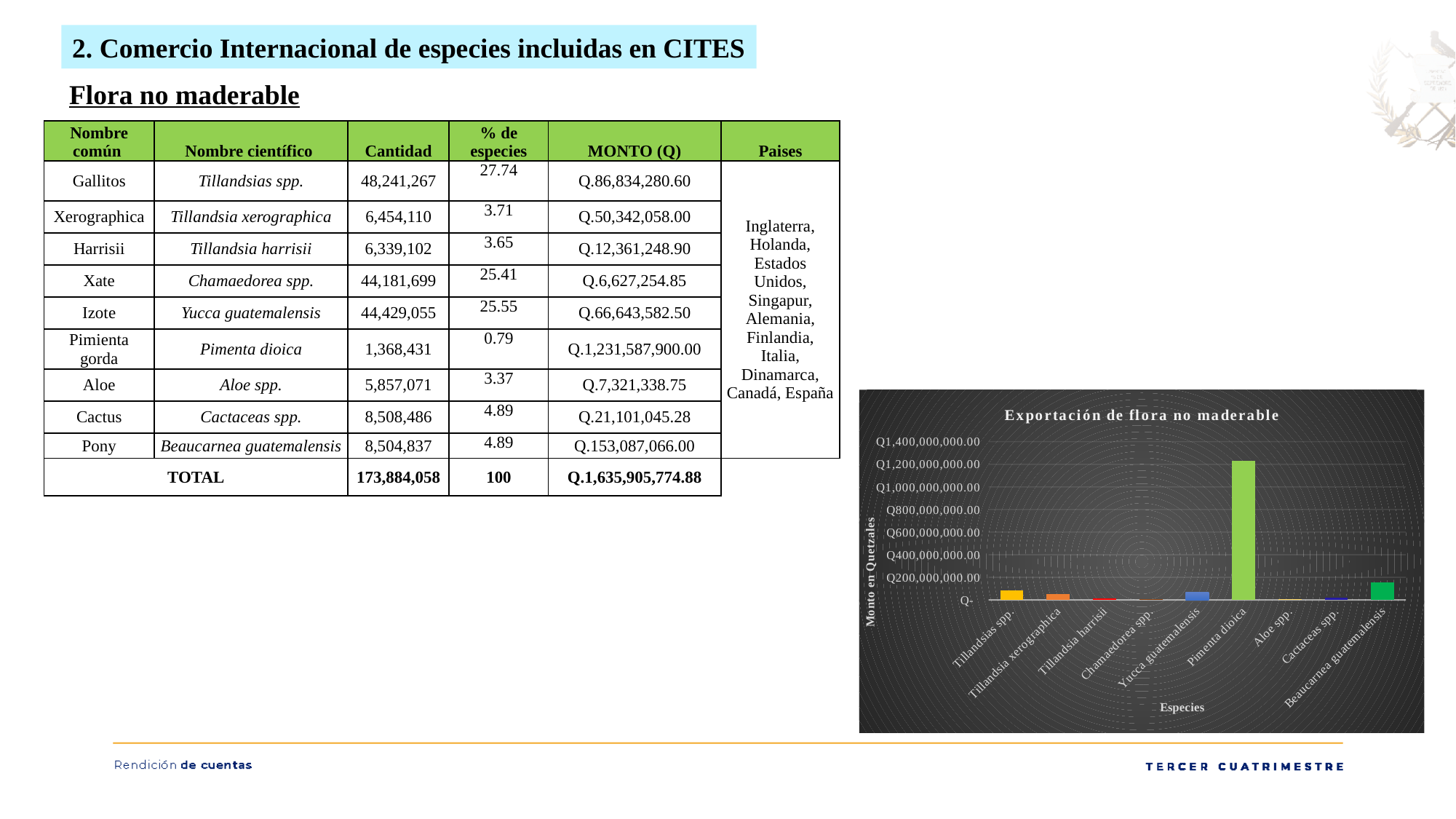
What kind of chart is shown on the slide? bar chart What is the title of the chart? Exportación de flora no maderable In the chart, which bar is taller: Tillandsias spp. or Tillandsia harrisii? Tillandsias spp. Is the value for Tillandsias spp. in the chart greater or less than Q200,000,000.00? less What is the label of the vertical axis of the chart? Monto en Quetzales Which species has the highest bar in the chart? Pimenta dioica According to the table on the slide, what is the MONTO (Q) for Pimenta dioica, the tallest bar in the chart? Q.1,231,587,900.00 Is the value for Beaucarnea guatemalensis in the chart greater or less than Q200,000,000.00? less In the chart, which bar is taller: Pimenta dioica or Yucca guatemalensis? Pimenta dioica How many species categories are plotted on the x axis of the chart? 9 In the chart, which bar is taller: Beaucarnea guatemalensis or Tillandsias spp.? Beaucarnea guatemalensis